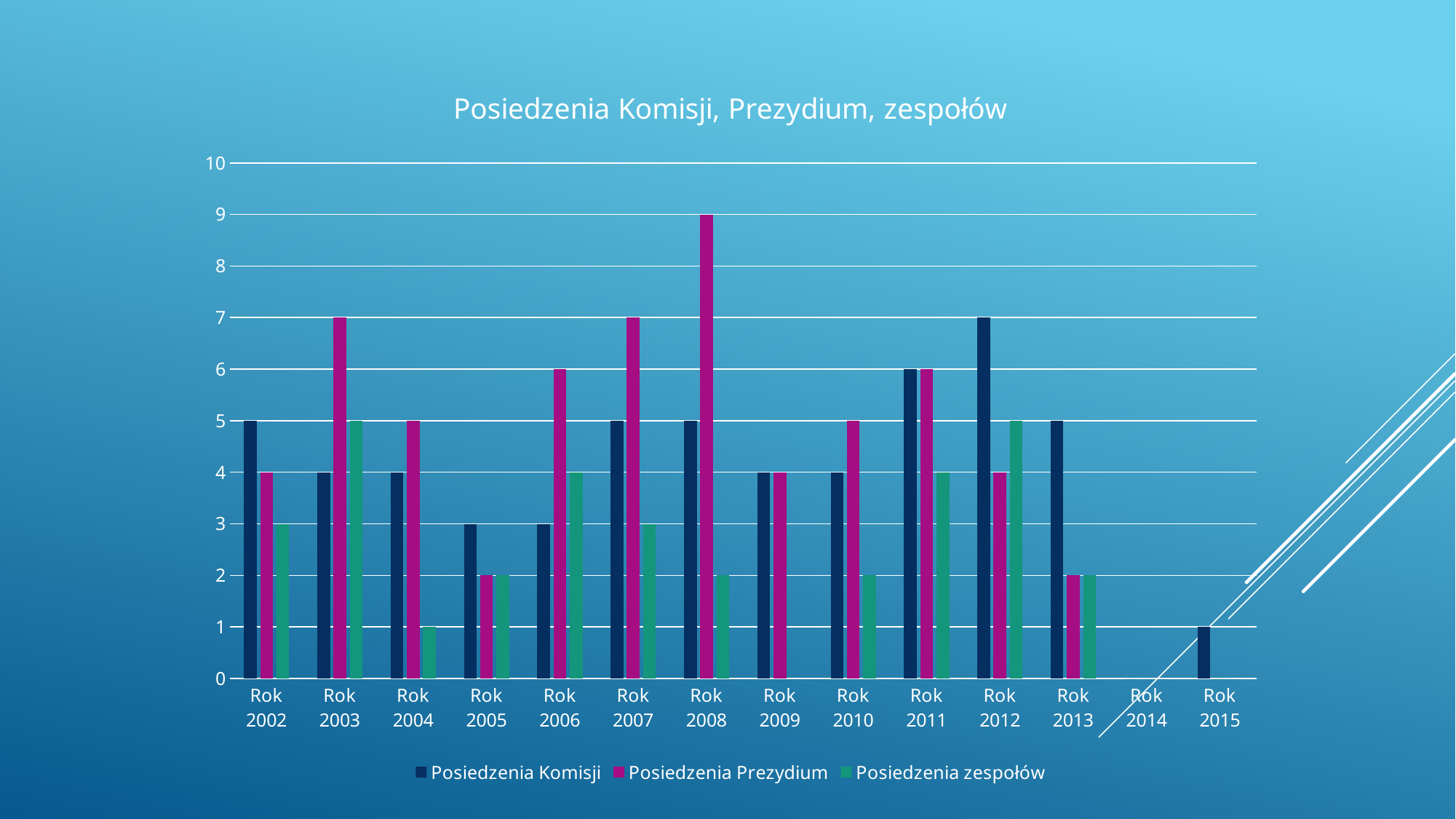
How many series does the legend list? 3 What kind of chart is shown on the slide? bar chart What is the title of the chart? Posiedzenia Komisji, Prezydium, zespołów What is the value for Posiedzenia zespołów in Rok 2004? 1 What is the difference between Posiedzenia Prezydium and Posiedzenia Komisji in Rok 2003? 3 How many year categories are shown on the x axis? 14 In which year is the value for Posiedzenia Komisji highest? Rok 2012 Is the value for Posiedzenia Prezydium in Rok 2006 greater or less than 5? greater What is the value for Posiedzenia Komisji in Rok 2015? 1 Which is larger in Rok 2012: Posiedzenia Komisji or Posiedzenia Prezydium? Posiedzenia Komisji What is the value for Posiedzenia Prezydium in Rok 2008? 9 In which year is the value for Posiedzenia Prezydium highest? Rok 2008